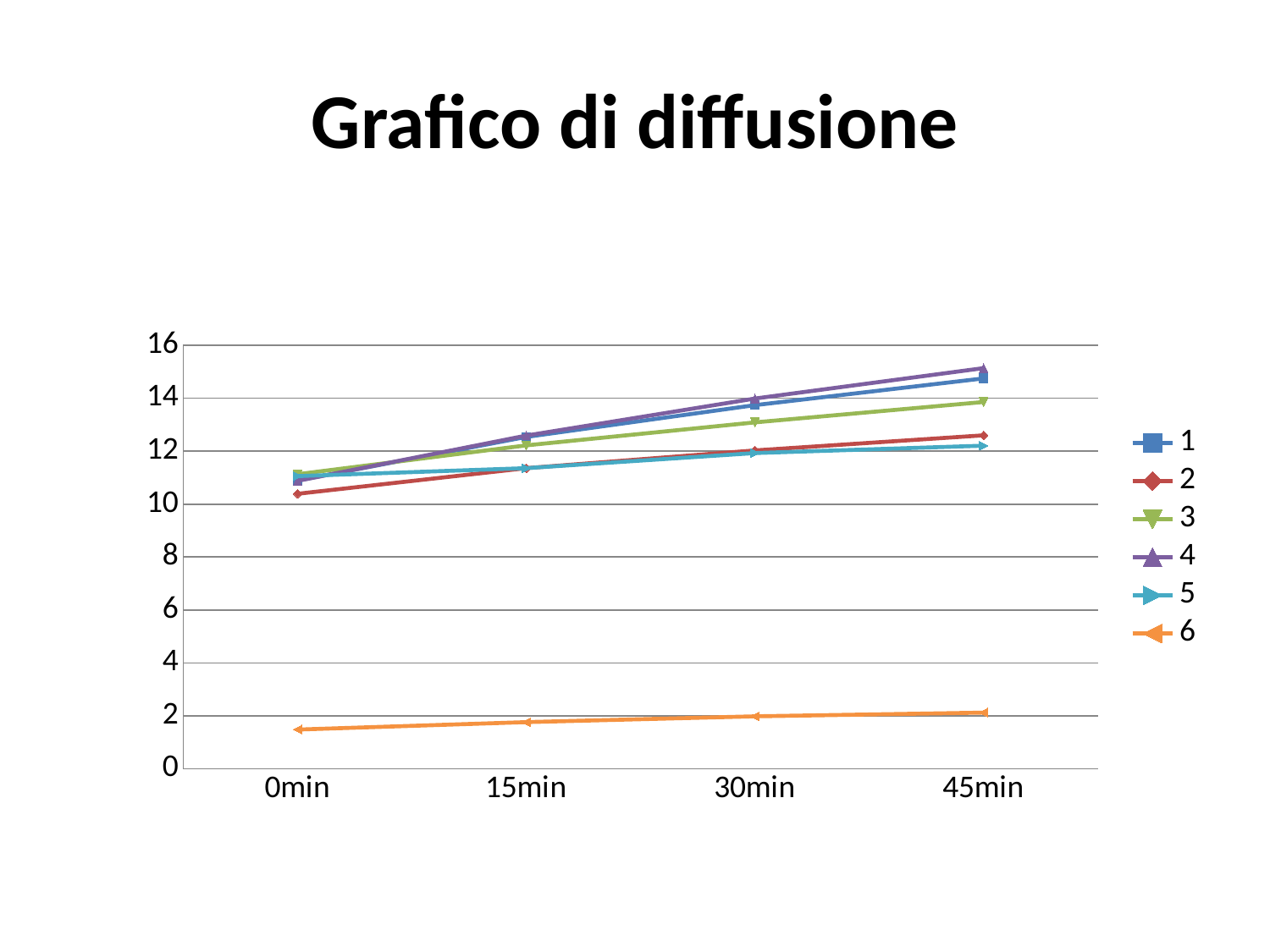
How many series does the legend list? 6 Do the values of series 6 rise or fall from 0min to 45min? rise At 45min, which is larger: the value for series 4 or the value for series 6? series 4 How many time points are shown on the x axis? 4 What is the title of the chart? Grafico di diffusione What kind of chart is shown on the slide? line chart Is the value for series 1 at 30min greater or less than 12? greater Which series has the lowest values across all time points? 6 Is the value for series 4 at 45min greater or less than 14? greater At 30min, which is larger: the value for series 1 or the value for series 2? series 1 Is the value for series 6 at 45min greater or less than 4? less Do the values of series 1 rise or fall from 0min to 45min? rise